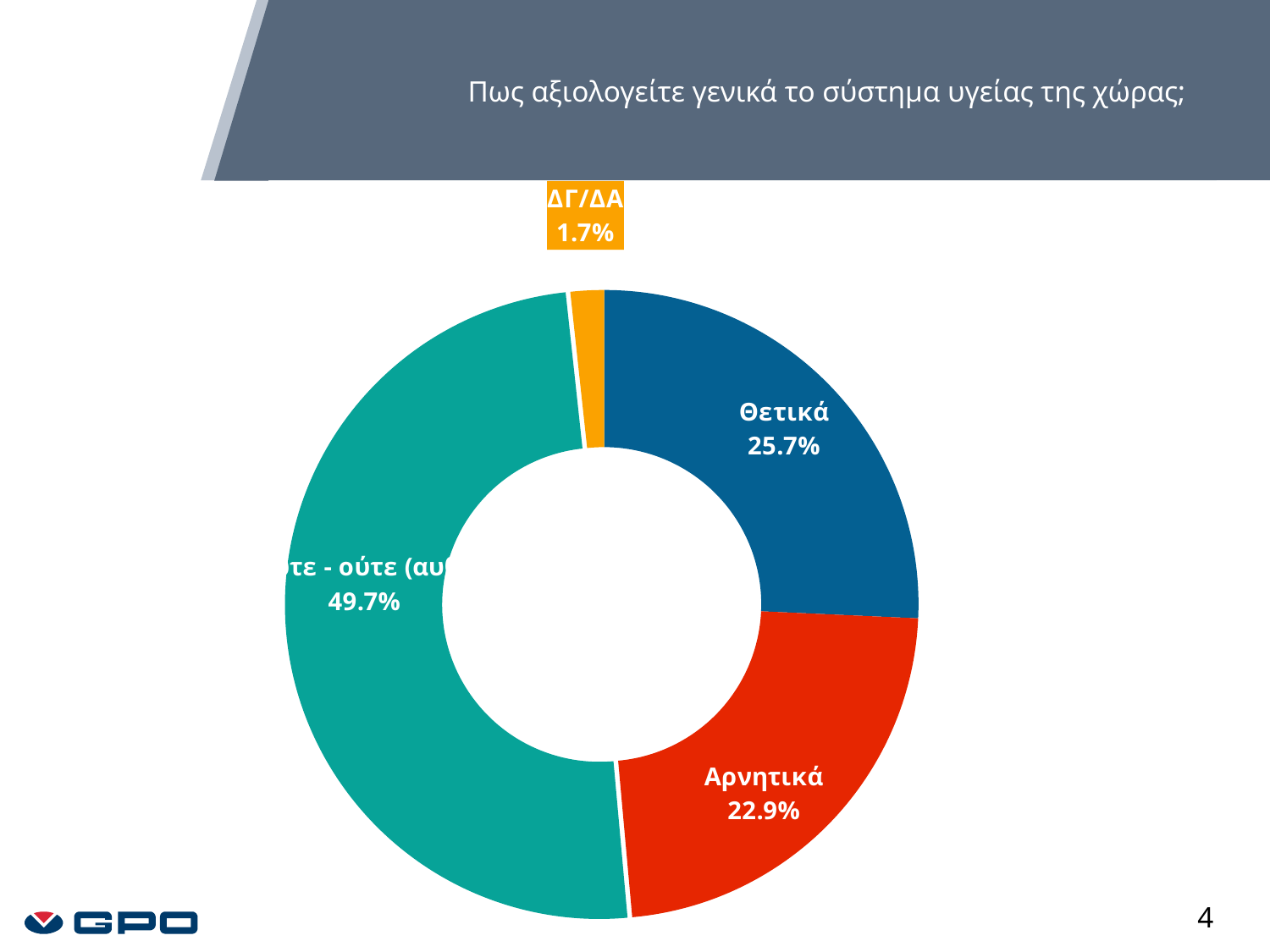
What is the title of the chart on the slide? Πως αξιολογείτε γενικά το σύστημα υγείας της χώρας; What is the difference between the Θετικά and ΔΓ/ΔΑ percentages? 24.0% What percentage is shown for Αρνητικά? 22.9% What percentage is shown for ΔΓ/ΔΑ? 1.7% Which category has the smallest slice in the chart? ΔΓ/ΔΑ What percentage is shown for Θετικά? 25.7% What kind of chart is shown on the slide? Pie chart (doughnut) What is the value of the largest slice in the chart? 49.7% What is the difference between the Θετικά and Αρνητικά percentages? 2.8% How many slices does the chart have? 4 What colour is the Αρνητικά slice? Red Which is larger, Θετικά or Αρνητικά? Θετικά